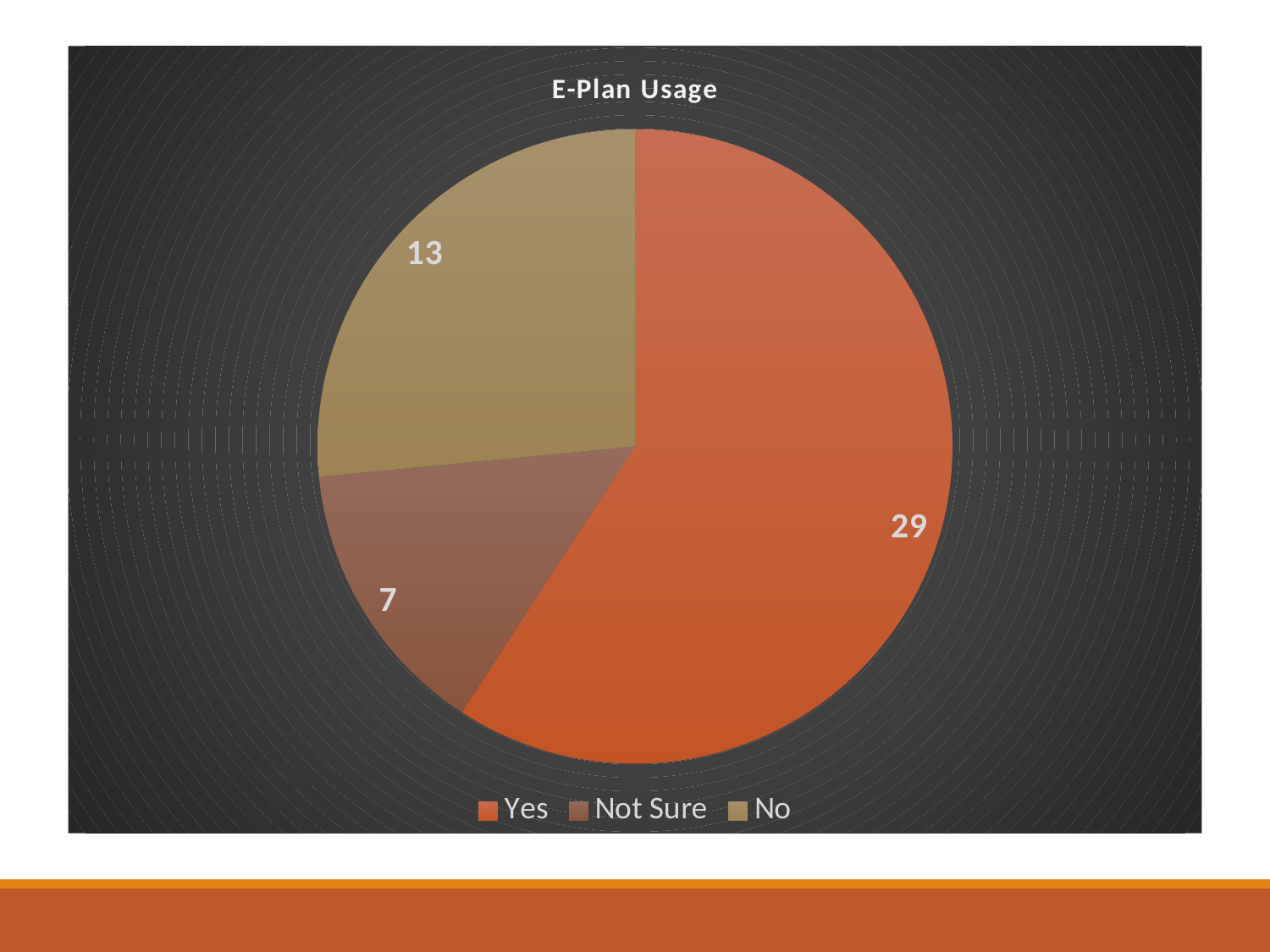
What is the difference between the Yes and No values in the E-Plan Usage chart? 16 What is the total of all slices in the E-Plan Usage chart? 49 How many categories are shown in the E-Plan Usage pie chart? 3 What kind of chart is shown on the slide? Pie chart What is the value for Yes in the E-Plan Usage pie chart? 29 What is the value for Not Sure in the E-Plan Usage pie chart? 7 Which category has the largest slice in the E-Plan Usage chart? Yes Which is larger in the E-Plan Usage chart, No or Not Sure? No What is the value for No in the E-Plan Usage pie chart? 13 What is the difference between the No and Not Sure values in the E-Plan Usage chart? 6 Which category has the smallest slice in the E-Plan Usage chart? Not Sure What is the title of the chart on the slide? E-Plan Usage